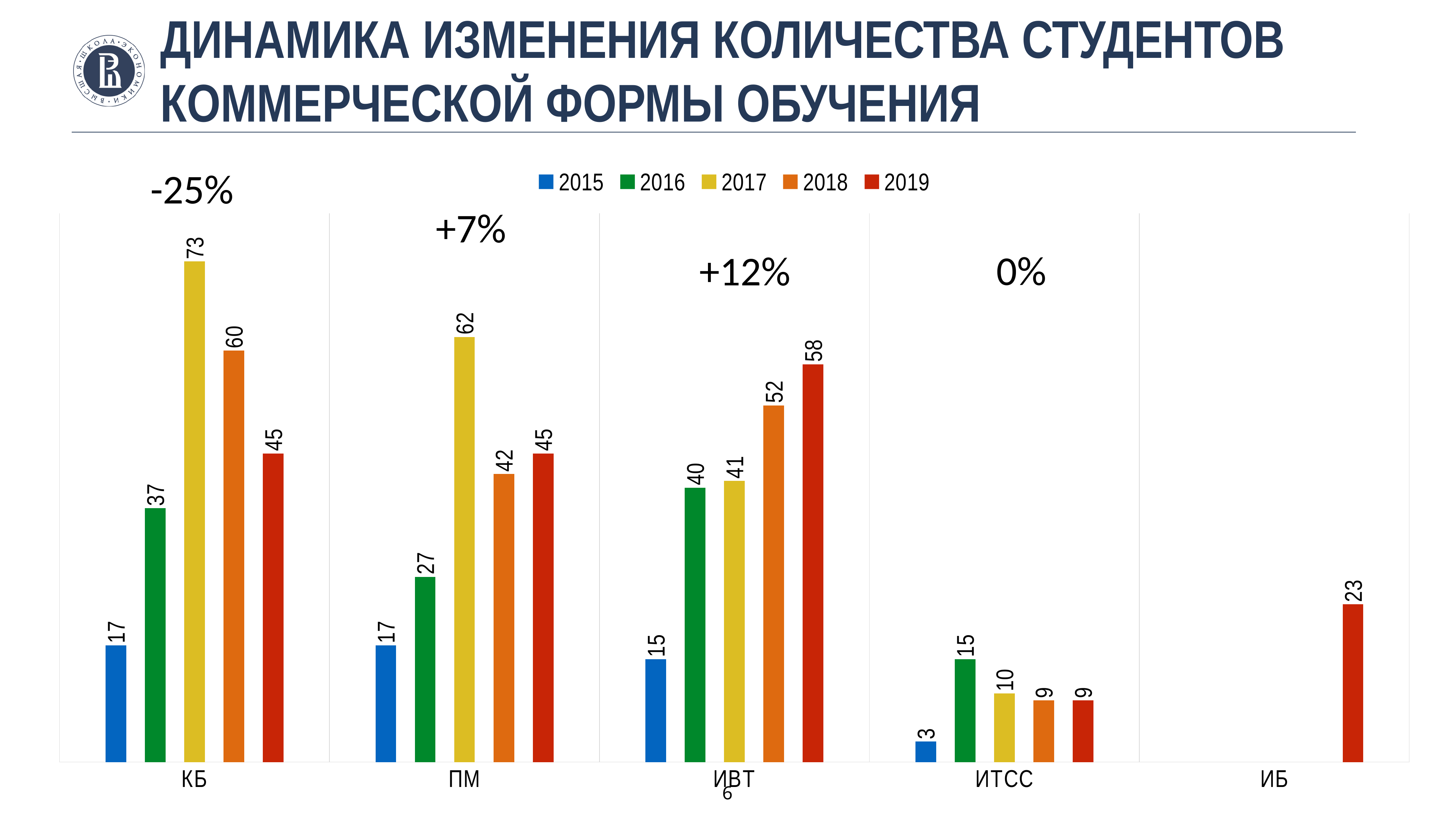
What is the difference between the 2017 and 2019 values for КБ? 28 What is the value for ИВТ in 2019? 58 What kind of chart is shown on the slide? bar chart Which is larger: the 2018 value for ПМ or the 2018 value for ИВТ? ИВТ What is the value for ИБ in 2019? 23 Which year has the highest value for ПМ? 2017 How many categories are shown on the x axis? 5 How many series does the legend list? 5 What is the value for ИТСС in 2015? 3 What percentage change is annotated above the ИВТ group? +12% Which year has the lowest value for ИВТ? 2015 What is the value for КБ in 2017? 73